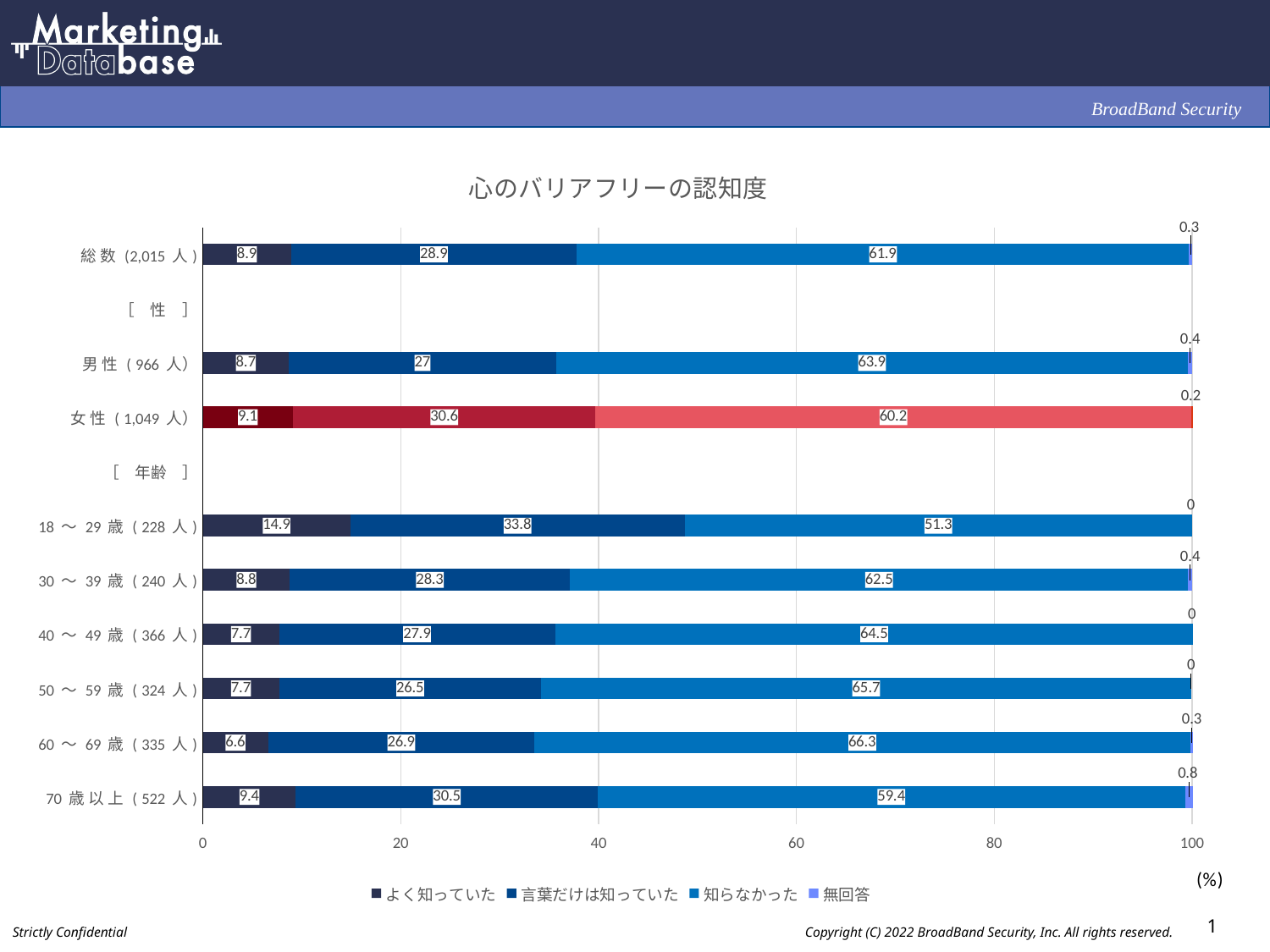
What is the value of よく知っていた for 総数 (2,015人)? 8.9 Which is larger, the 言葉だけは知っていた value for 70歳以上 (522人) or for 50～59歳 (324人)? 70歳以上 (522人) What is the difference between the 知らなかった values for 男性 (966人) and 女性 (1,049人)? 3.7 What is the title of the chart? 心のバリアフリーの認知度 What is the value of 無回答 for 70歳以上 (522人)? 0.8 What is the value of 言葉だけは知っていた for 18～29歳 (228人)? 33.8 Which category has the highest value for よく知っていた? 18～29歳 (228人) What is the value of 知らなかった for 女性 (1,049人)? 60.2 Which category has the lowest value for よく知っていた? 60～69歳 (335人) What kind of chart is shown on the slide? Stacked bar chart Which category has the highest value for 知らなかった? 60～69歳 (335人) How many series does the legend list? 4